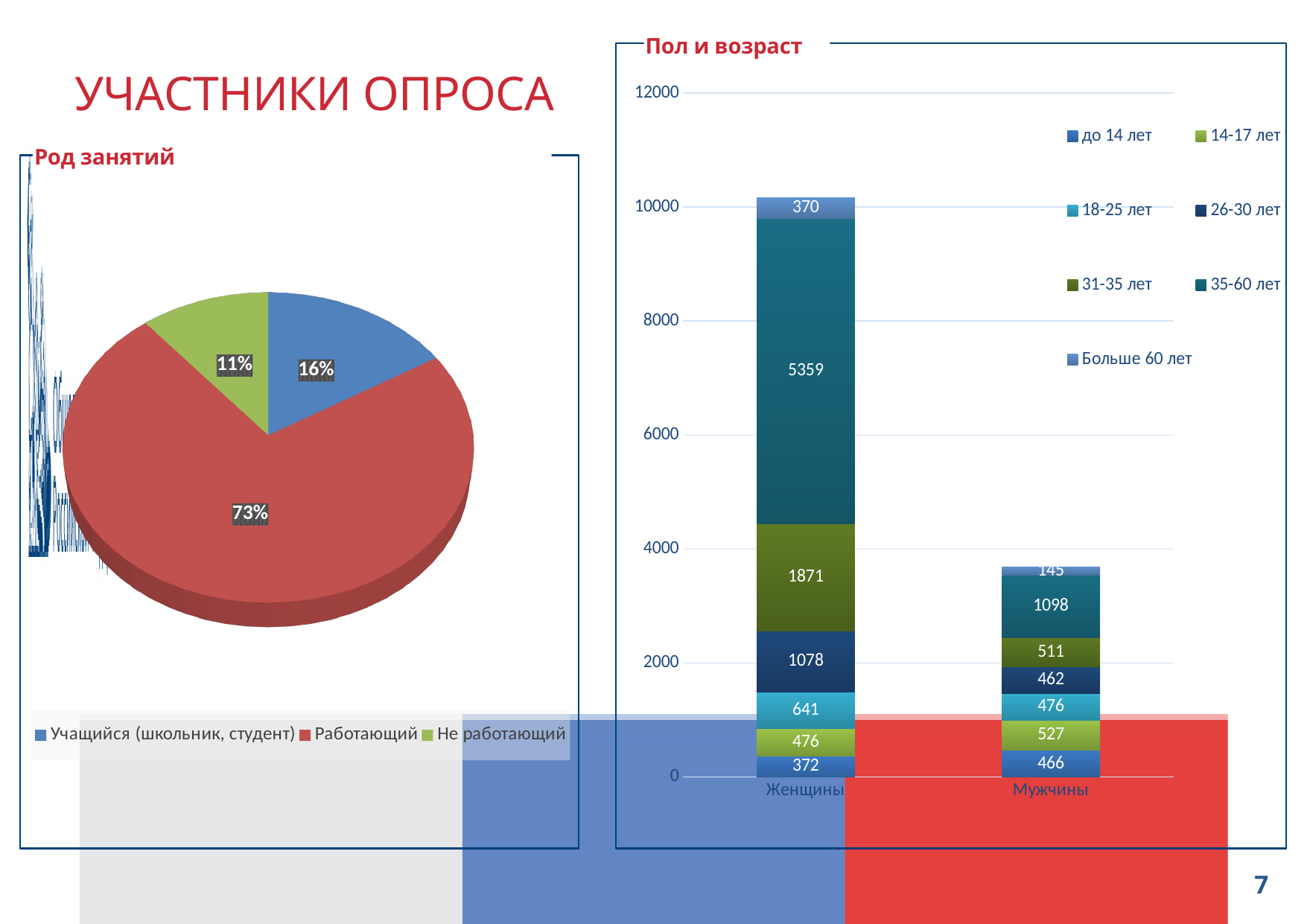
On the 'Пол и возраст' chart, what is the value for 14-17 лет in the Мужчины bar? 527 On the 'Пол и возраст' chart, what is the value for 35-60 лет in the Женщины bar? 5359 On the 'Пол и возраст' chart, is the total for Женщины greater or less than 10000? greater On the 'Пол и возраст' chart, which is larger: the 18-25 лет value for Женщины or for Мужчины? Женщины On the 'Пол и возраст' chart, how many series does the legend list? 7 What kind of chart is the 'Род занятий' chart? Pie chart On the 'Пол и возраст' chart, what is the difference between the 26-30 лет values for Женщины and Мужчины? 616 On the 'Род занятий' pie chart, what share is labelled for Работающий? 73% On the 'Пол и возраст' chart, what is the value for Больше 60 лет in the Женщины bar? 370 On the 'Род занятий' pie chart, which category has the smallest slice? Не работающий On the 'Пол и возраст' chart, what is the total of the Мужчины stacked bar? 3685 On the 'Род занятий' pie chart, what share is labelled for Учащийся (школьник, студент)? 16%